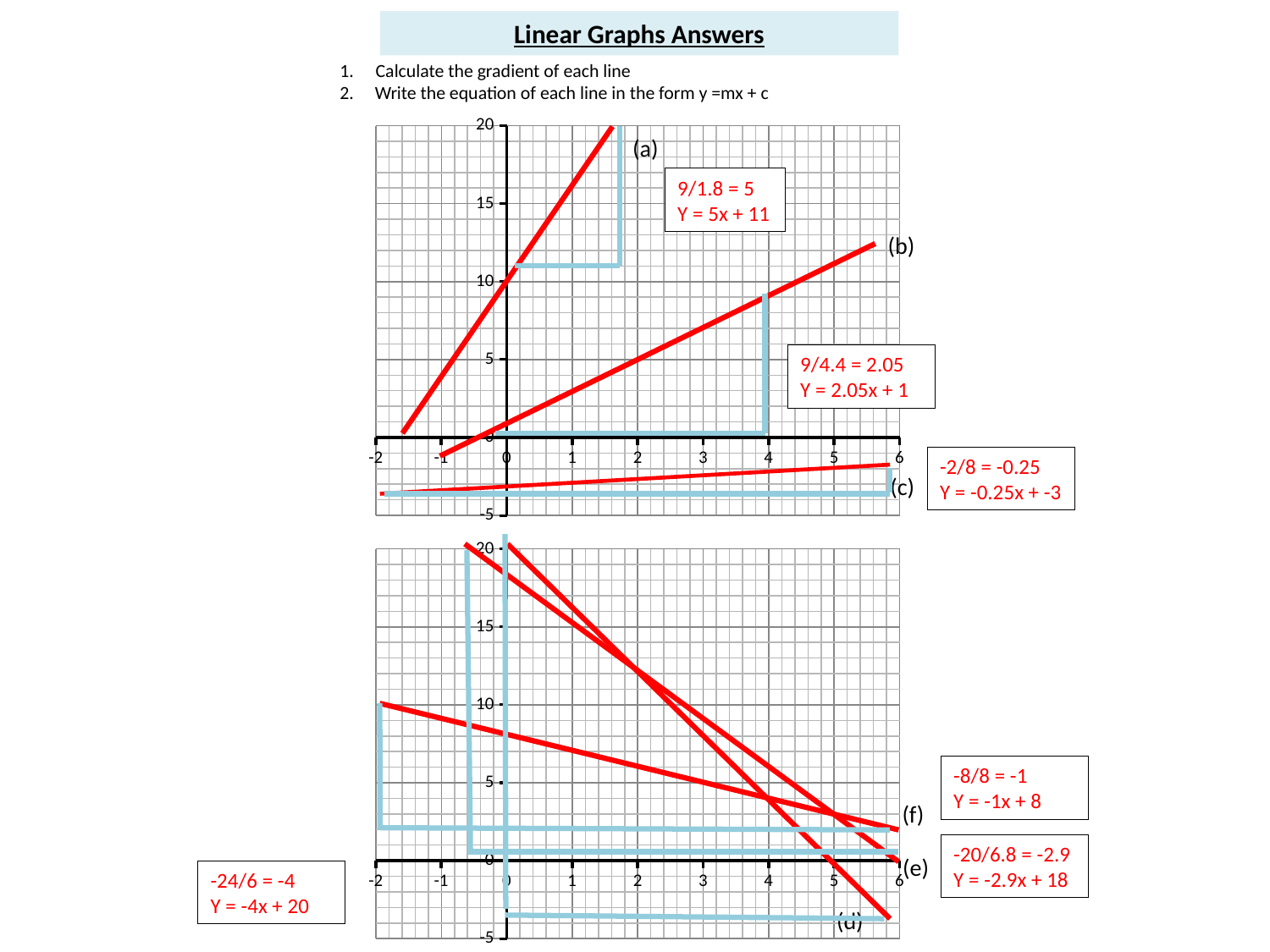
How many lines are plotted on the top chart? 3 On the top chart, what gradient is given for line (a)? 5 On the top chart, what equation is given for line (b)? Y = 2.05x + 1 On the top chart, which line has the steepest gradient? (a) How many lines are plotted on the bottom chart? 3 On the bottom chart, what equation is given for line (f)? Y = -1x + 8 On the bottom chart, what gradient is given for line (e)? -2.9 On the bottom chart, does line (f) rise or fall as x increases? fall What is the title of the slide? Linear Graphs Answers On the top chart, what gradient is given for line (c)? -0.25 What kind of chart is shown on the slide? line chart